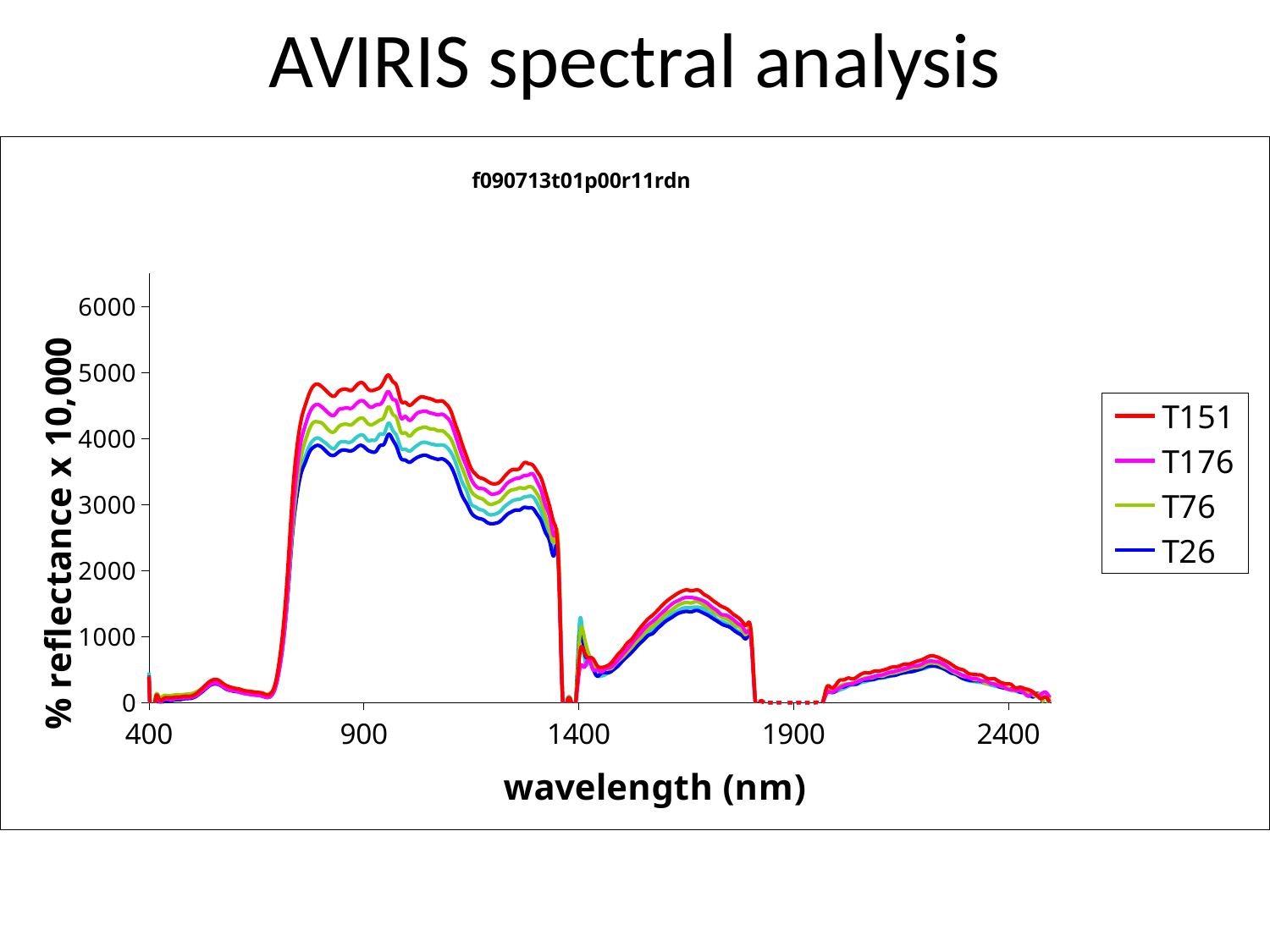
What is the title printed above the chart? f090713t01p00r11rdn Which legend series has the lowest values around 900 nm? T26 Around 900 nm, which is larger: the value for T151 or the value for T26? T151 What is the label of the x axis? wavelength (nm) Is the value for T26 around 900 nm greater or less than 4500? less What kind of chart is shown on the slide? line chart Which series has the highest values around 900 nm? T151 Do the values rise or fall along the x axis between 1450 nm and 1650 nm? rise Is the value for T151 around 1650 nm greater or less than 1000? greater Is the value for T151 around 1900 nm greater or less than 1000? less How many series does the legend list? 4